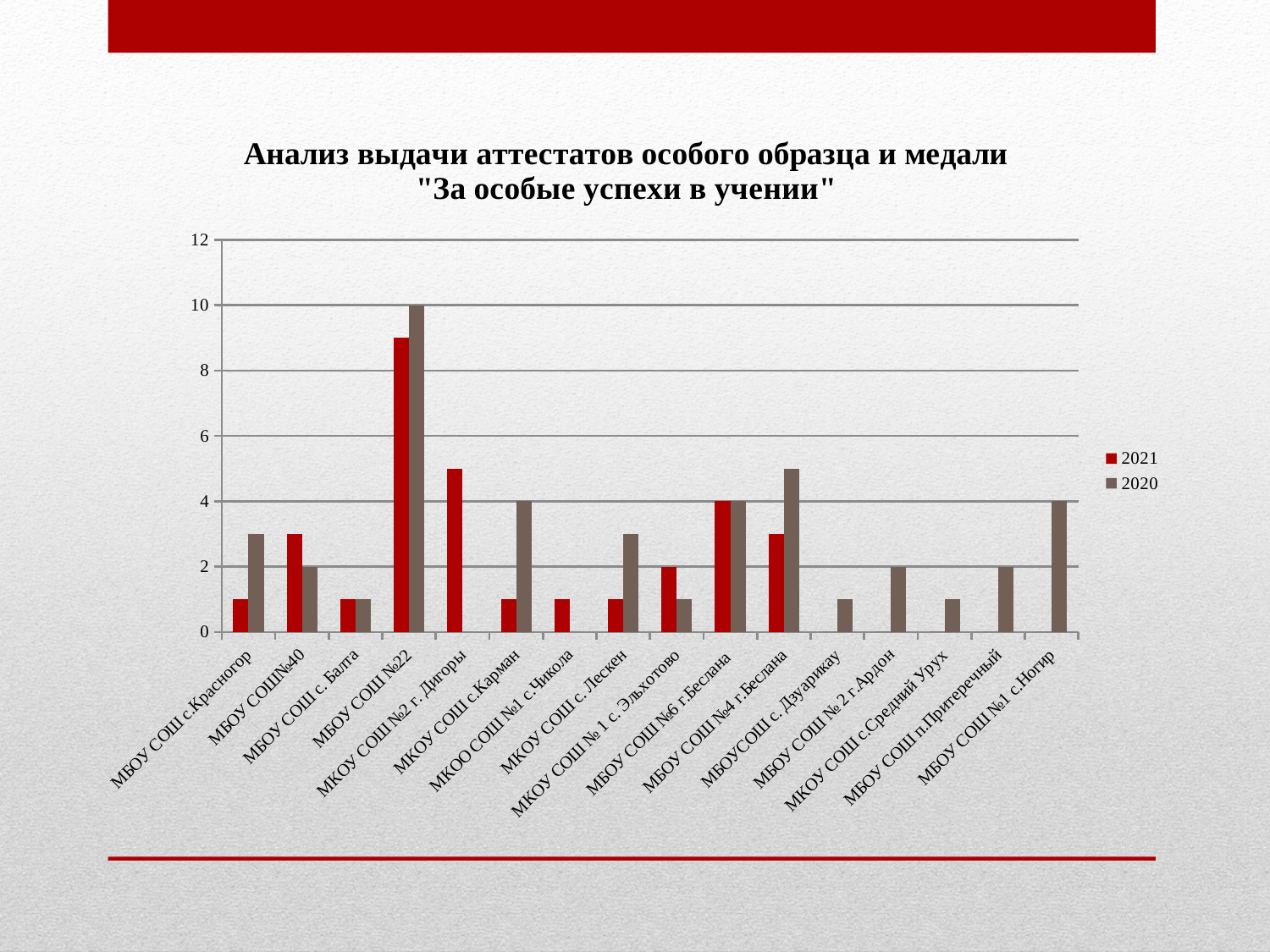
What are the two entries listed in the legend? 2021 and 2020 Is the 2021 value for МКОУ СОШ №2 г. Дигоры greater or less than 4? greater For МКОУ СОШ с.Карман, which series has the larger value, 2021 or 2020? 2020 Which school has the highest value for 2020? МБОУ СОШ №22 What is the 2020 value for МКОУ СОШ с.Карман? 4 What kind of chart is shown on the slide? bar chart What is the 2020 value for МБОУ СОШ № 2 г.Ардон? 2 How many schools (categories) are shown on the x axis? 16 Which school has the highest value for 2021? МБОУ СОШ №22 What is the 2020 value for МБОУ СОШ №22? 10 How many series does the legend list? 2 What is the 2021 value for МБОУ СОШ №6 г.Беслана? 4